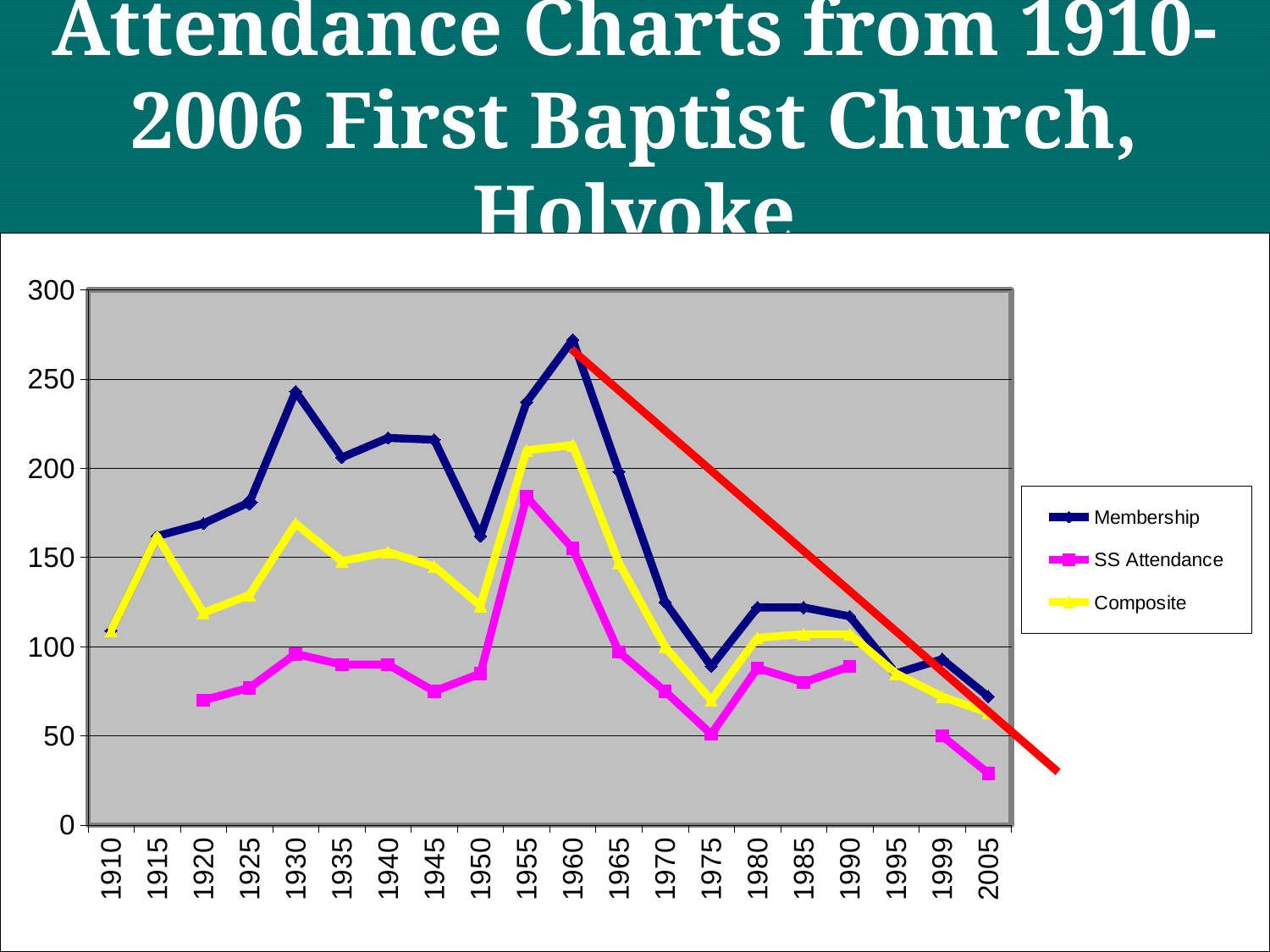
What kind of chart is shown on the slide? Line chart Is the Membership value for 1960 greater or less than 250? greater How many series does the legend list? 3 Does the Membership series rise or fall between 1960 and 1975? Fall In 1960, which is larger: Membership or SS Attendance? Membership In which year is the SS Attendance series at its lowest? 2005 What are the three series named in the legend? Membership, SS Attendance, Composite Is the SS Attendance value for 2005 greater or less than 50? less Is the Composite value for 1975 greater or less than 100? less In which year does the Membership series reach its highest value? 1960 How many years are labelled along the x axis? 20 In which year does the SS Attendance series reach its highest value? 1955